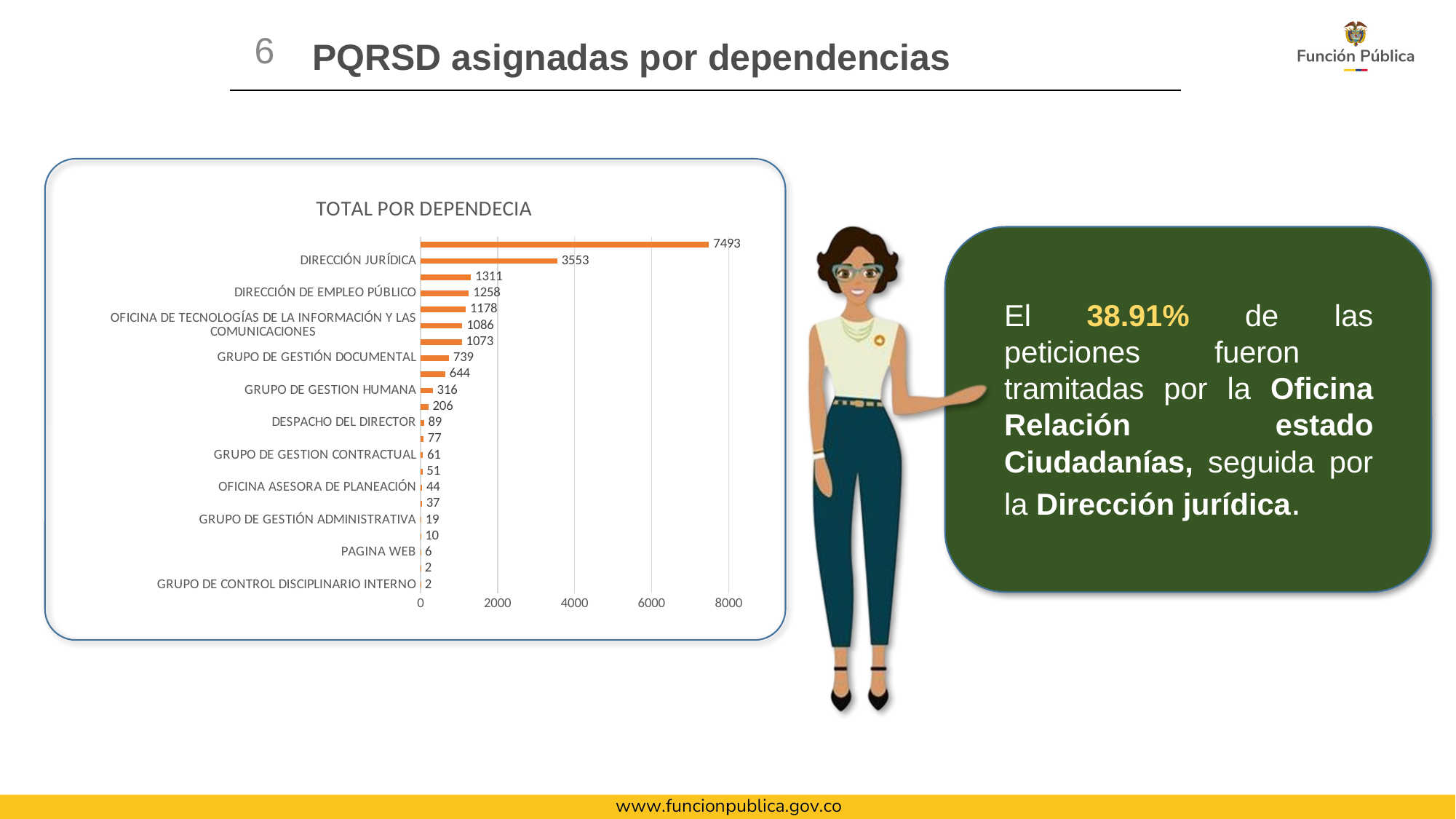
How many bars are plotted in the chart? 22 What is the value for PAGINA WEB? 6 Which has a larger value, GRUPO DE GESTIÓN DOCUMENTAL or GRUPO DE GESTION HUMANA? GRUPO DE GESTIÓN DOCUMENTAL What is the value for DIRECCIÓN DE EMPLEO PÚBLICO? 1258 What is the highest value shown in the chart? 7493 What is the difference between the values for DIRECCIÓN JURÍDICA and DIRECCIÓN DE EMPLEO PÚBLICO? 2295 What type of chart is shown on the slide? Bar chart What is the lowest value shown in the chart? 2 What is the value for DIRECCIÓN JURÍDICA? 3553 What is the title of the chart? TOTAL POR DEPENDECIA What is the value for GRUPO DE GESTIÓN DOCUMENTAL? 739 What is the value for DESPACHO DEL DIRECTOR? 89